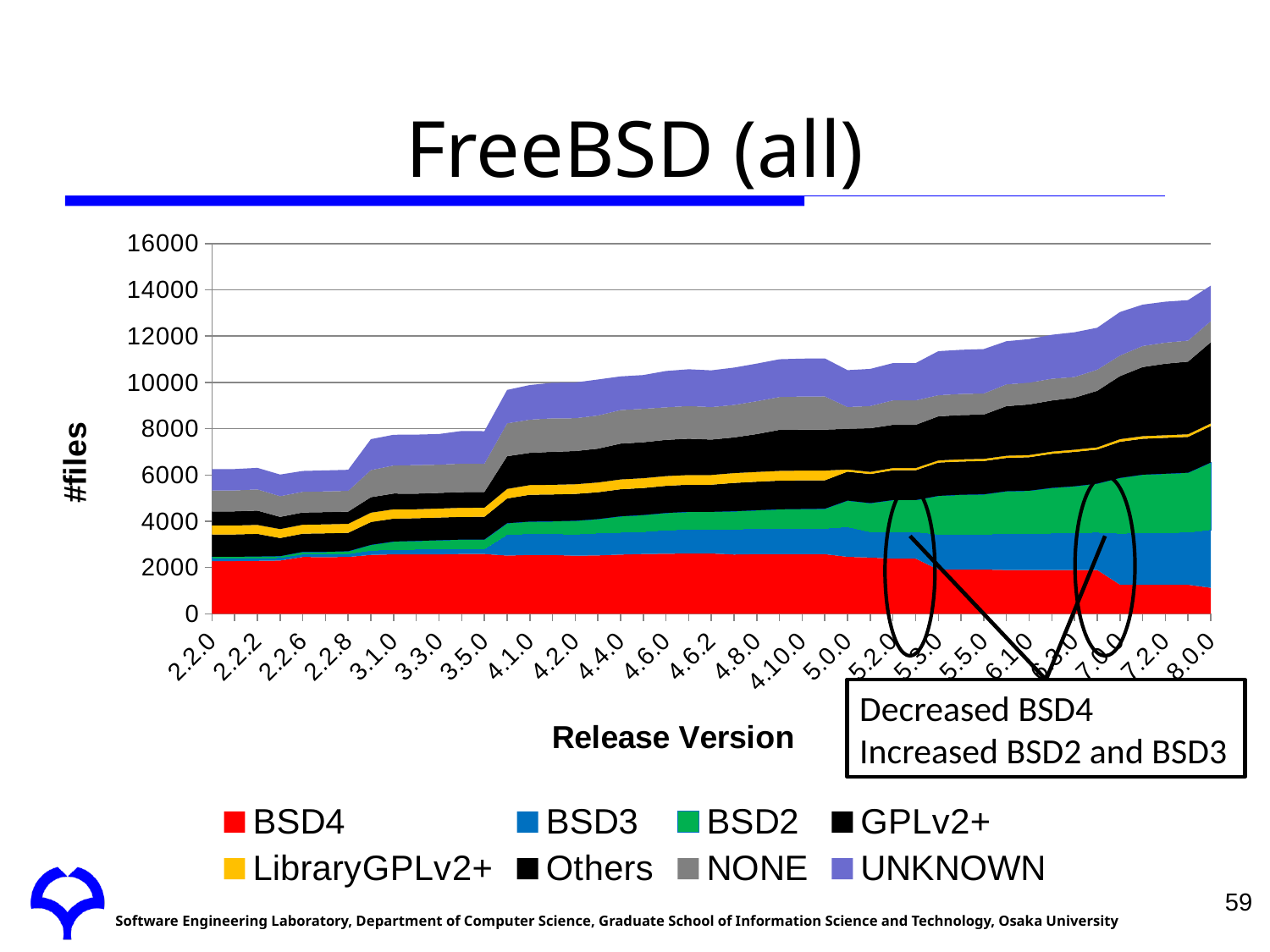
Which release has the larger total number of files, 2.2.0 or 8.0.0? 8.0.0 What is the label of the x axis? Release Version Is the total number of files at release 4.1.0 greater or less than 8000? greater Is the total number of files at release 2.2.0 greater or less than 8000? less What is the label of the y axis? #files Which release version has the highest total number of files? 8.0.0 Is the number of BSD4 files at release 8.0.0 greater or less than 2000? less How many series does the legend list? 8 What kind of chart is shown on the slide? Stacked area chart Does the total number of files generally rise or fall from release 2.2.0 to 8.0.0? Rise Which release has more BSD4 files, 5.2.0 or 8.0.0? 5.2.0